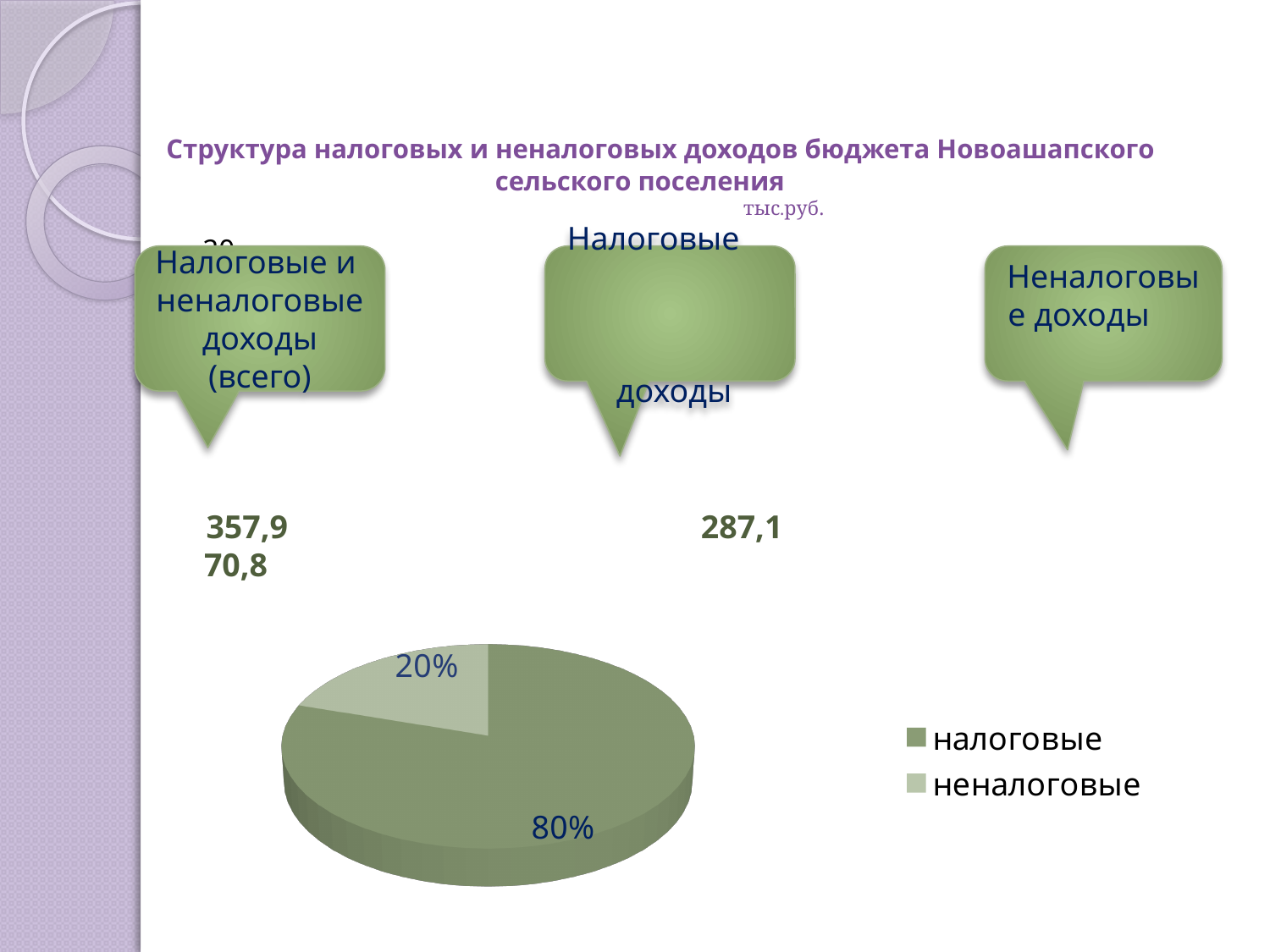
What kind of chart is shown on the slide? pie chart Which is larger in the pie chart, налоговые or неналоговые? налоговые How many entries does the legend of the pie chart list? 2 How many slices does the pie chart have? 2 What share of the pie chart is labelled налоговые? 80% Which slice of the pie chart is the largest? налоговые What is the title of the slide above the chart? Структура налоговых и неналоговых доходов бюджета Новоашапского сельского поселения Which slice of the pie chart is the smallest? неналоговые By how many percentage points does the налоговые slice exceed the неналоговые slice? 60 percentage points What are the two legend entries of the pie chart? налоговые, неналоговые What share of the pie chart is labelled неналоговые? 20%